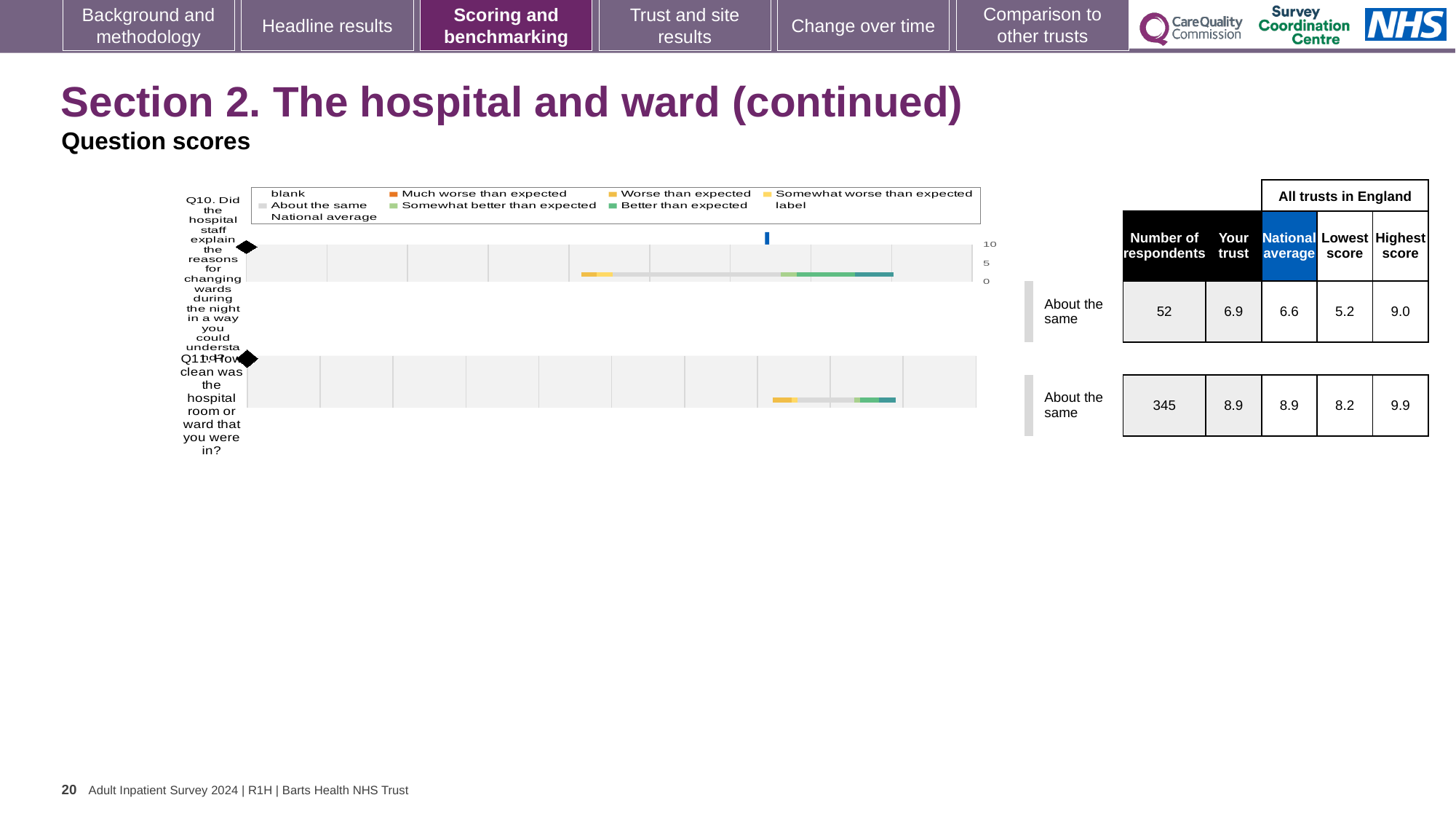
How many respondents answered Q11? 345 Which legend entry is shown in dark orange on the chart legend? Much worse than expected What kind of chart is used to show the question scores for Q10 and Q11? bar chart What is the national average score for Q11 (how clean was the hospital room or ward)? 8.9 What is the lowest score across all trusts in England for Q10? 5.2 What is the 'Your trust' score for Q10 (explaining reasons for changing wards during the night)? 6.9 What is the highest score across all trusts in England for Q11? 9.9 What benchmark category is shown for Q11? About the same What is the difference between the highest and lowest scores for Q10? 3.8 How many survey questions are plotted on the slide's charts? 2 Which question has the higher 'Your trust' score, Q10 or Q11? Q11 What is the maximum value shown on the score axis of the Q10 chart? 10